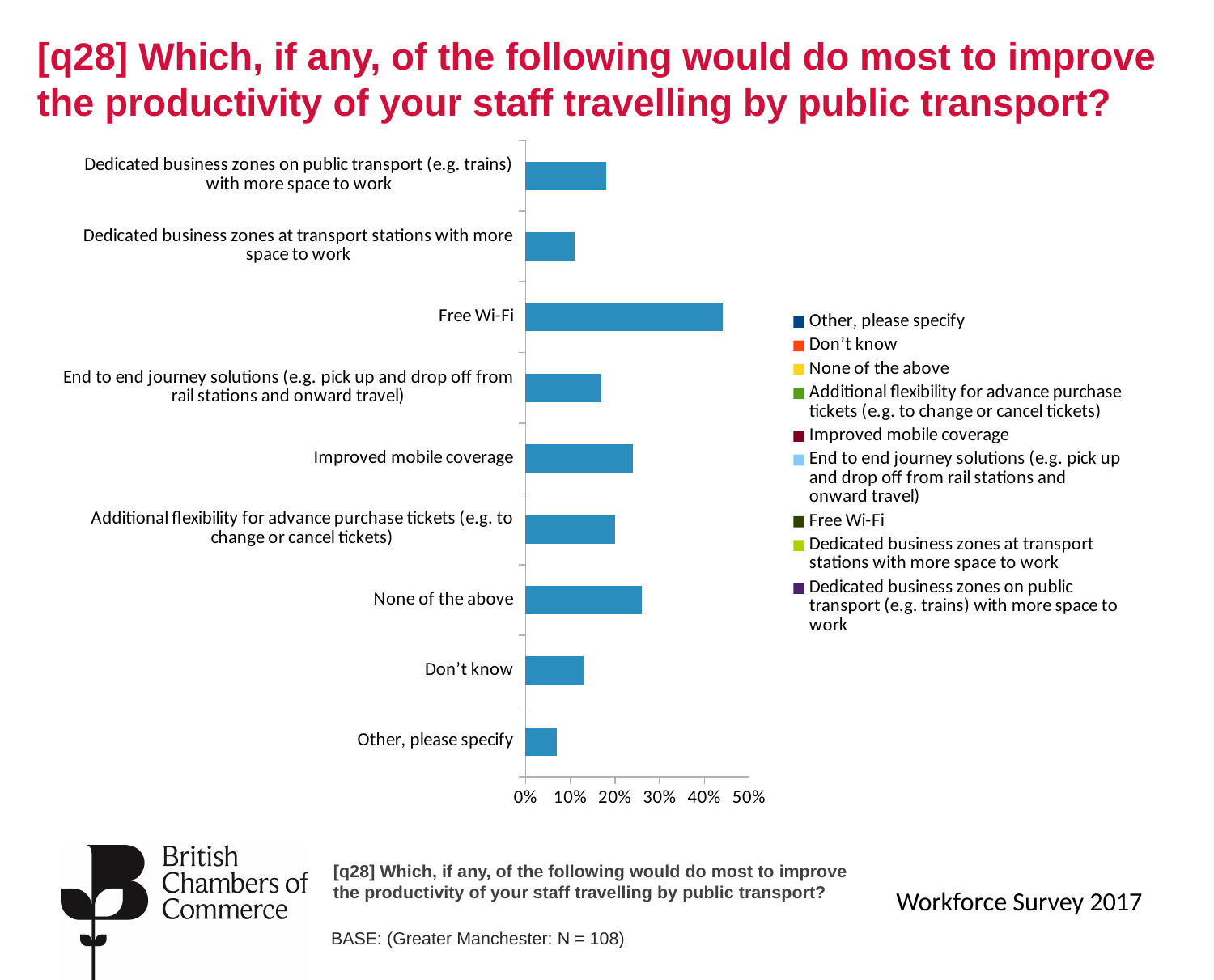
Is the value for Free Wi-Fi greater or less than 40%? greater Which category has the lowest value in the chart? Other, please specify Which category has the highest value in the chart? Free Wi-Fi Is the value for Other, please specify greater or less than 10%? less Is the value for End to end journey solutions (e.g. pick up and drop off from rail stations and onward travel) greater or less than 20%? less Which has the larger value: Dedicated business zones on public transport (e.g. trains) with more space to work or Dedicated business zones at transport stations with more space to work? Dedicated business zones on public transport (e.g. trains) with more space to work How many categories are plotted in the chart? 9 Which has the larger value: Free Wi-Fi or None of the above? Free Wi-Fi How many entries does the legend list? 9 What kind of chart is shown on the slide? bar chart What is the highest value shown on the horizontal axis of the chart? 50%